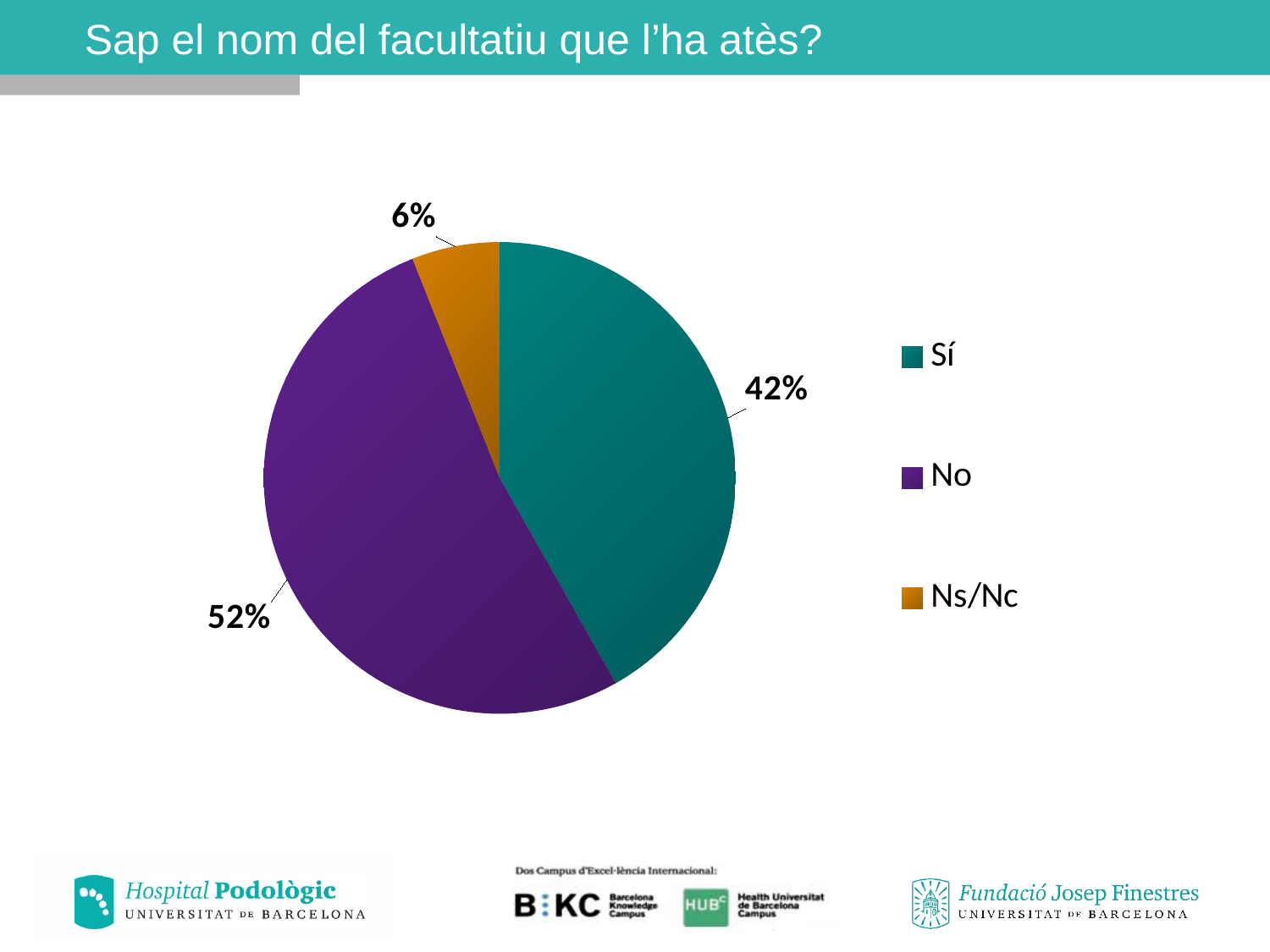
What percentage of the pie chart corresponds to "Sí"? 42% What percentage of the pie chart corresponds to "Ns/Nc"? 6% How many slices does the pie chart have? 3 Which category has the smallest share of the pie chart? Ns/Nc What colour is the "No" slice in the pie chart? Purple Which category has the largest share of the pie chart? No What percentage of the pie chart corresponds to "No"? 52% What is the title of the slide containing the chart? Sap el nom del facultatiu que l'ha atès? Which slice is larger, "Sí" or "Ns/Nc"? Sí What is the difference in percentage points between the "No" and "Sí" slices? 10 What type of chart is shown on the slide? Pie chart What is the combined share of the "Sí" and "No" slices? 94%